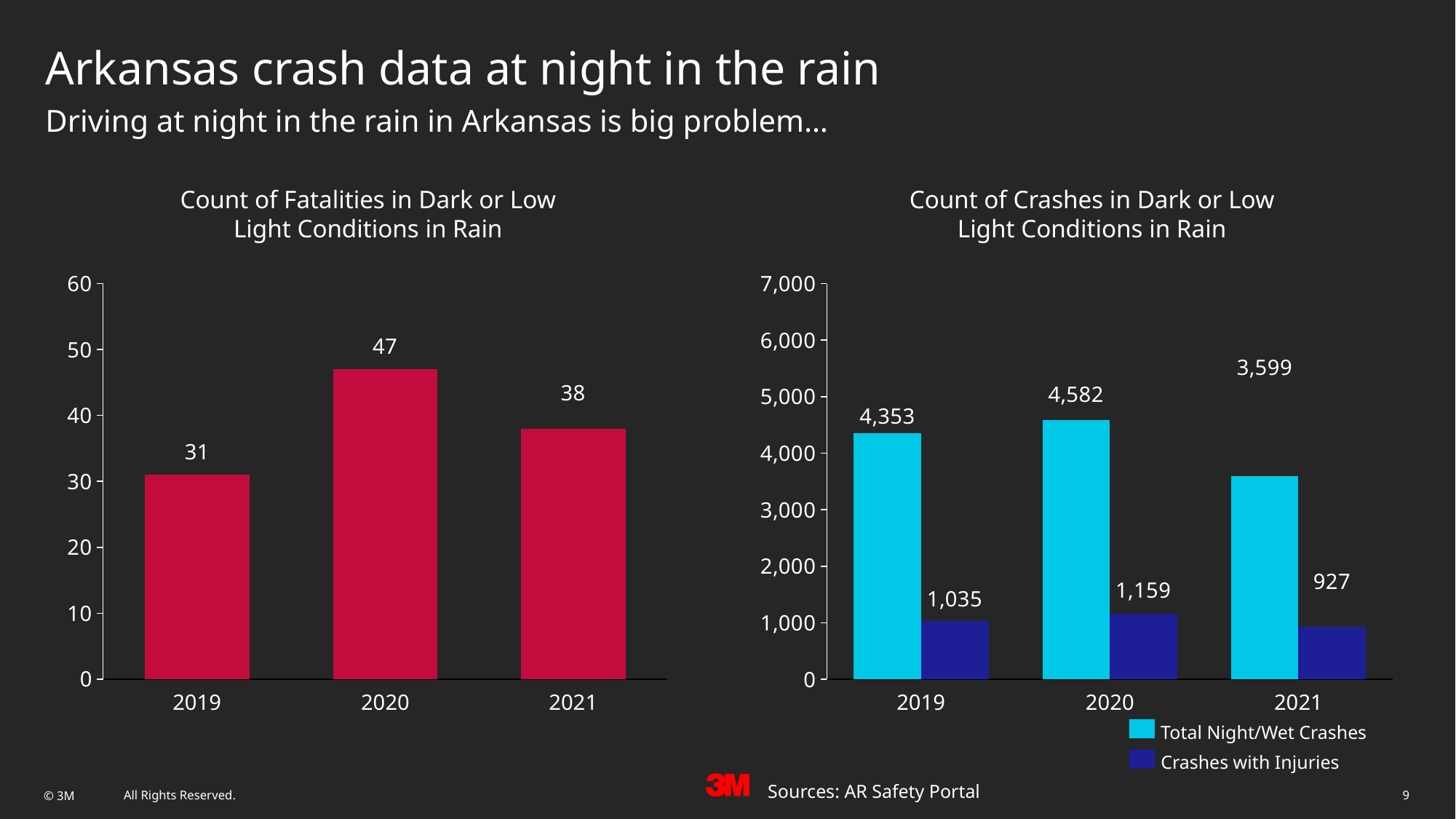
In the 'Count of Fatalities in Dark or Low Light Conditions in Rain' chart, how many years are shown? 3 In the 'Count of Crashes in Dark or Low Light Conditions in Rain' chart, what colour are the Crashes with Injuries bars? Dark blue How many series does the legend of the 'Count of Crashes in Dark or Low Light Conditions in Rain' chart list? 2 In the 'Count of Fatalities in Dark or Low Light Conditions in Rain' chart, which year has the lowest value? 2019 In the 'Count of Crashes in Dark or Low Light Conditions in Rain' chart, what is the value of Total Night/Wet Crashes for 2021? 3,599 What kind of chart is the 'Count of Fatalities in Dark or Low Light Conditions in Rain' chart? Bar chart In the 'Count of Crashes in Dark or Low Light Conditions in Rain' chart, is Crashes with Injuries for 2019 larger or smaller than for 2021? Larger In the 'Count of Crashes in Dark or Low Light Conditions in Rain' chart, which year has the highest Total Night/Wet Crashes? 2020 In the 'Count of Crashes in Dark or Low Light Conditions in Rain' chart, what is the value of Crashes with Injuries for 2020? 1,159 In the 'Count of Fatalities in Dark or Low Light Conditions in Rain' chart, what is the difference between the 2020 and 2021 values? 9 In the 'Count of Fatalities in Dark or Low Light Conditions in Rain' chart, what is the value for 2020? 47 In the 'Count of Crashes in Dark or Low Light Conditions in Rain' chart, what is the difference between Total Night/Wet Crashes in 2019 and 2020? 229